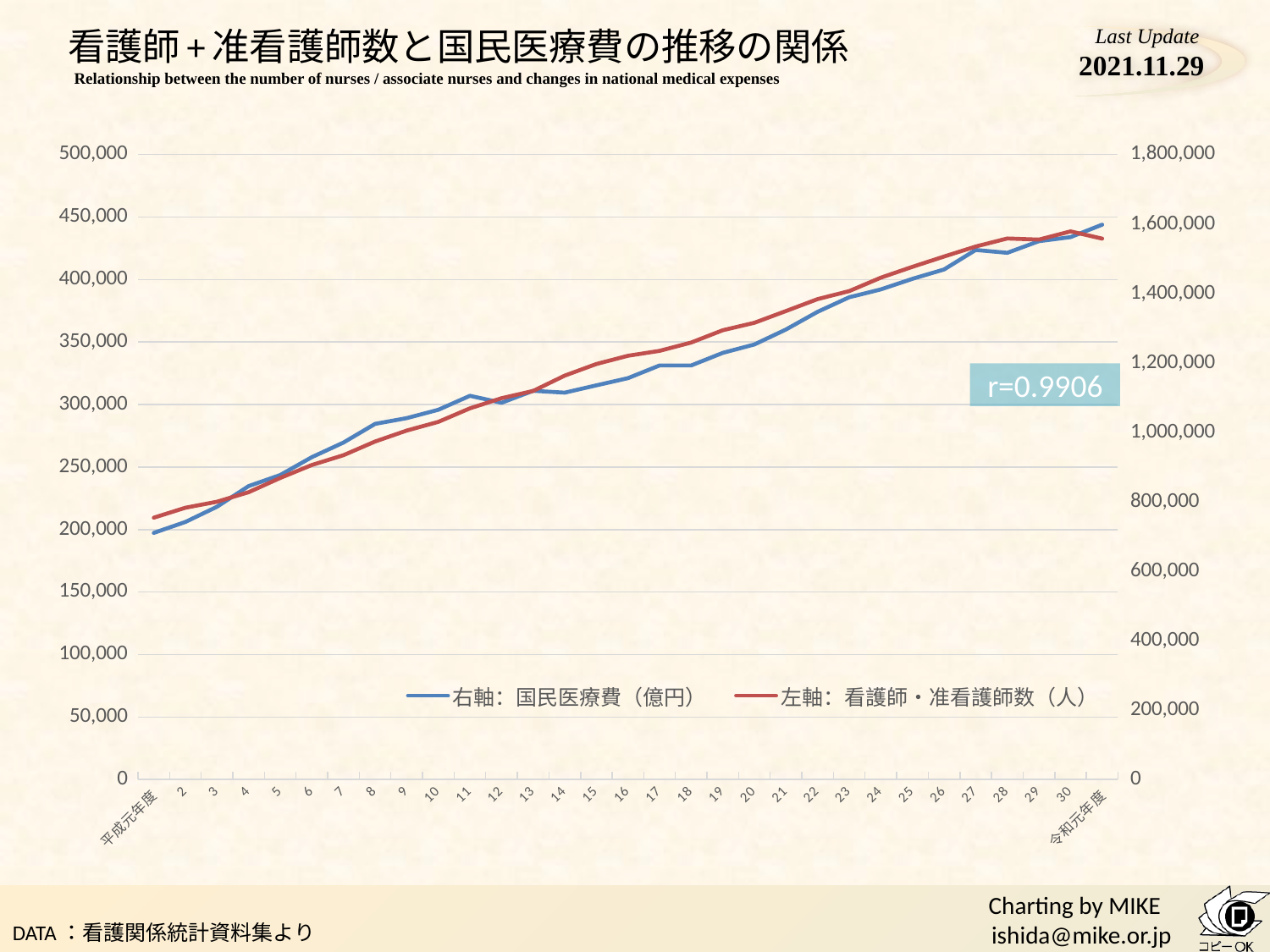
Which series is plotted on the right axis according to the legend? 国民医療費（億円） How many fiscal years are plotted along the x axis? 31 What correlation coefficient is shown on the chart? r=0.9906 Is the value of 国民医療費 (right axis) for 平成元年度 greater or less than 800,000? less How many series does the legend list? 2 Does the 国民医療費 line generally rise or fall from 平成元年度 to 令和元年度? rise Which fiscal year has the lowest value for 看護師・准看護師数? 平成元年度 Is the value of 看護師・准看護師数 (left axis) for 令和元年度 greater or less than 400,000? greater What kind of chart is shown on the slide? Line chart